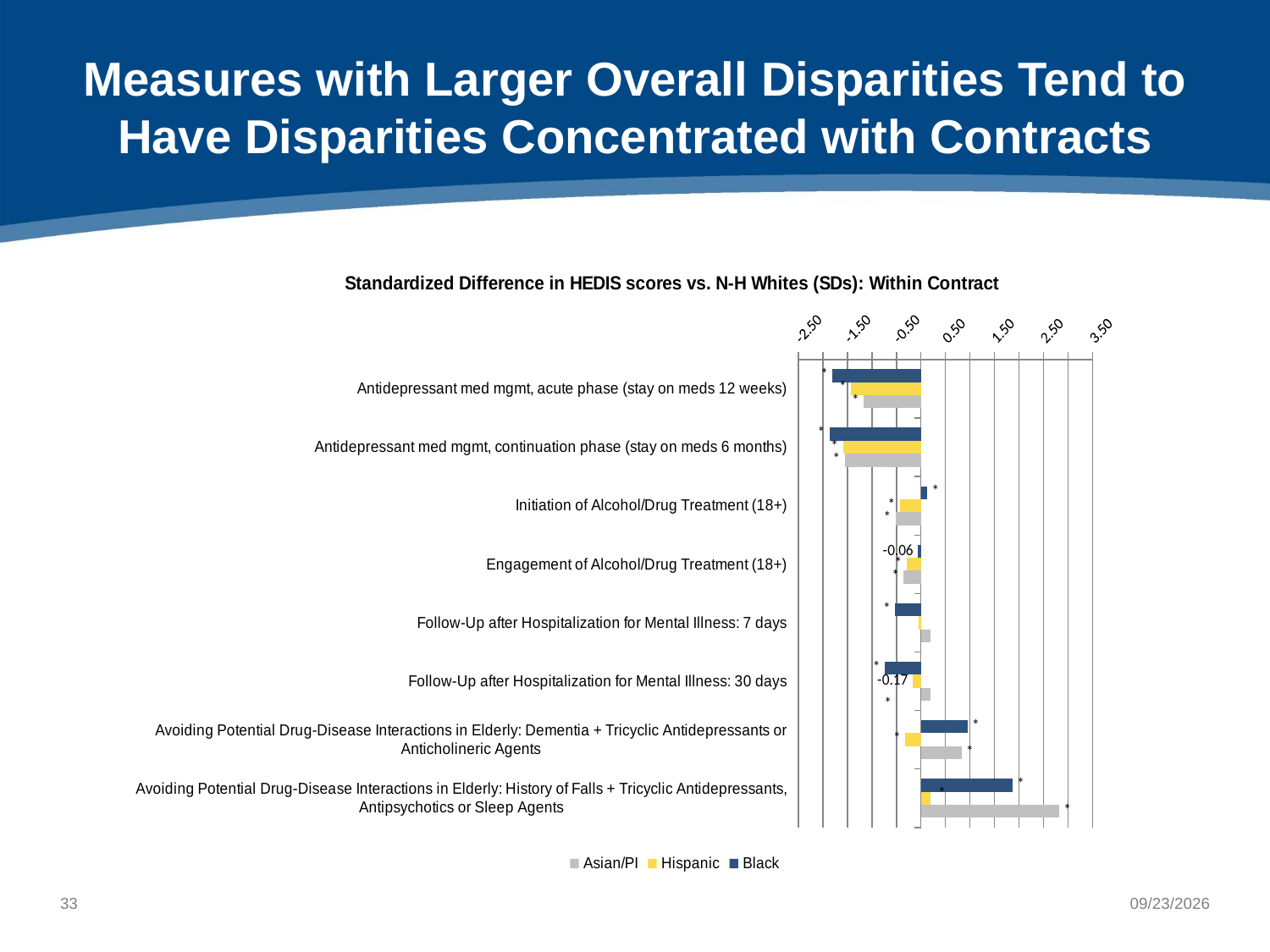
What data label is printed next to the bars for Engagement of Alcohol/Drug Treatment (18+)? -0.06 For which measure does the Asian/PI series reach its highest value? Avoiding Potential Drug-Disease Interactions in Elderly: History of Falls + Tricyclic Antidepressants, Antipsychotics or Sleep Agents Which series is shown in yellow in the legend? Hispanic Is the Asian/PI value for Avoiding Potential Drug-Disease Interactions in Elderly: History of Falls + Tricyclic Antidepressants, Antipsychotics or Sleep Agents greater or less than 2.50? greater What type of chart is shown on the slide? bar chart What is the title of the chart? Standardized Difference in HEDIS scores vs. N-H Whites (SDs): Within Contract How many series does the legend list? 3 What data label is printed next to the bars for Follow-Up after Hospitalization for Mental Illness: 30 days? -0.17 Is the Black value for Antidepressant med mgmt, acute phase (stay on meds 12 weeks) greater or less than -1.50? less For Avoiding Potential Drug-Disease Interactions in Elderly: History of Falls + Tricyclic Antidepressants, Antipsychotics or Sleep Agents, which is larger, the Black value or the Hispanic value? Black How many measures (categories) are plotted on the chart? 8 Is the Black value for Avoiding Potential Drug-Disease Interactions in Elderly: Dementia + Tricyclic Antidepressants or Anticholineric Agents greater or less than 0.50? greater